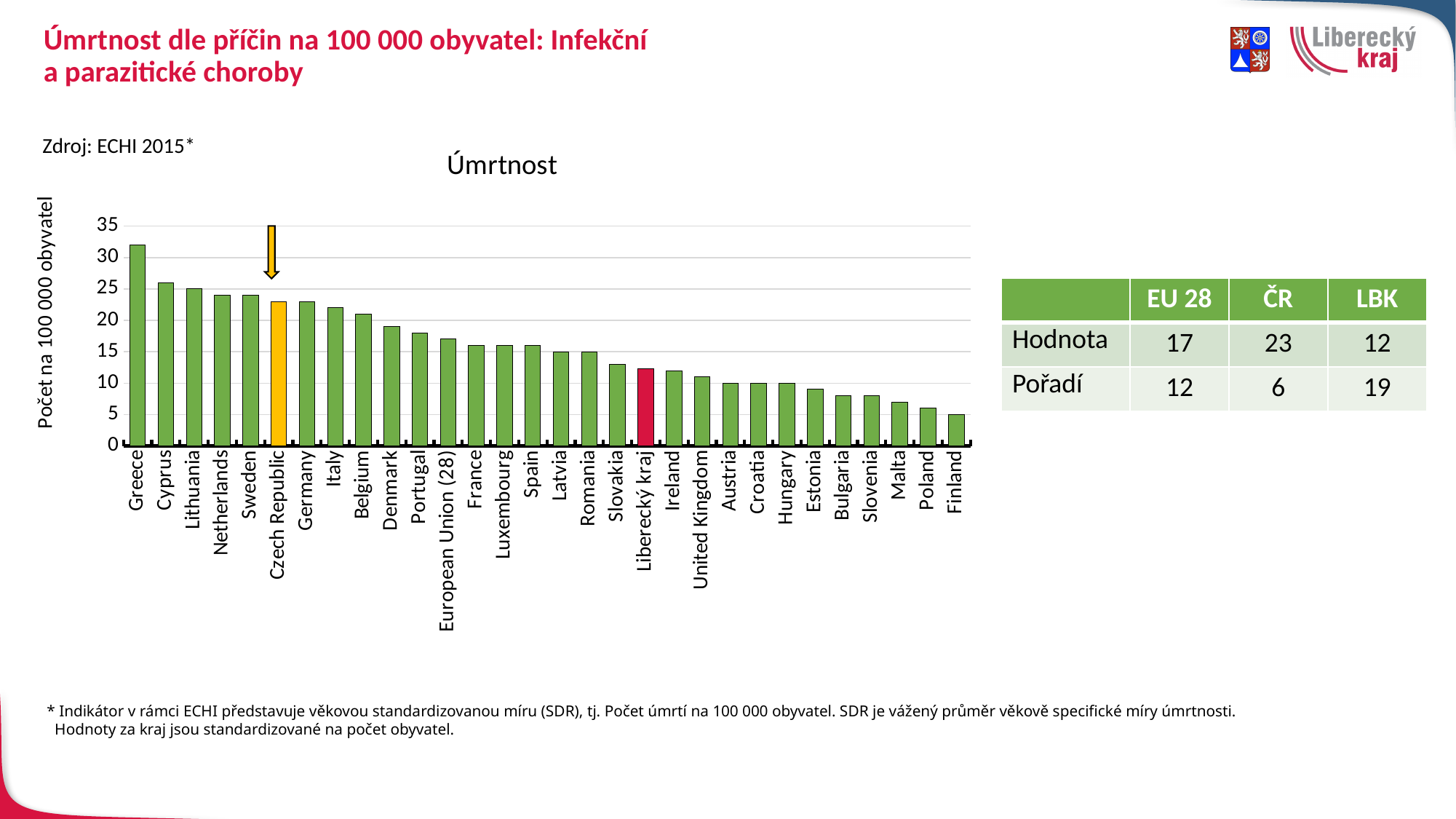
What is the title of the chart? Úmrtnost Which category has the lowest value in the chart? Finland Is the value for Poland greater or less than 10? less Do the values rise or fall moving from left to right along the x axis? fall Is the value for Greece greater or less than 30? greater Is the value for Slovakia greater or less than 10? greater Which has the larger value, Germany or Finland? Germany Which category has the highest value in the chart? Greece What is the label of the vertical axis of the chart? Počet na 100 000 obyvatel Which has the larger value, Greece or Cyprus? Greece How many countries/regions are plotted in the chart? 30 What kind of chart is shown on the slide? bar chart